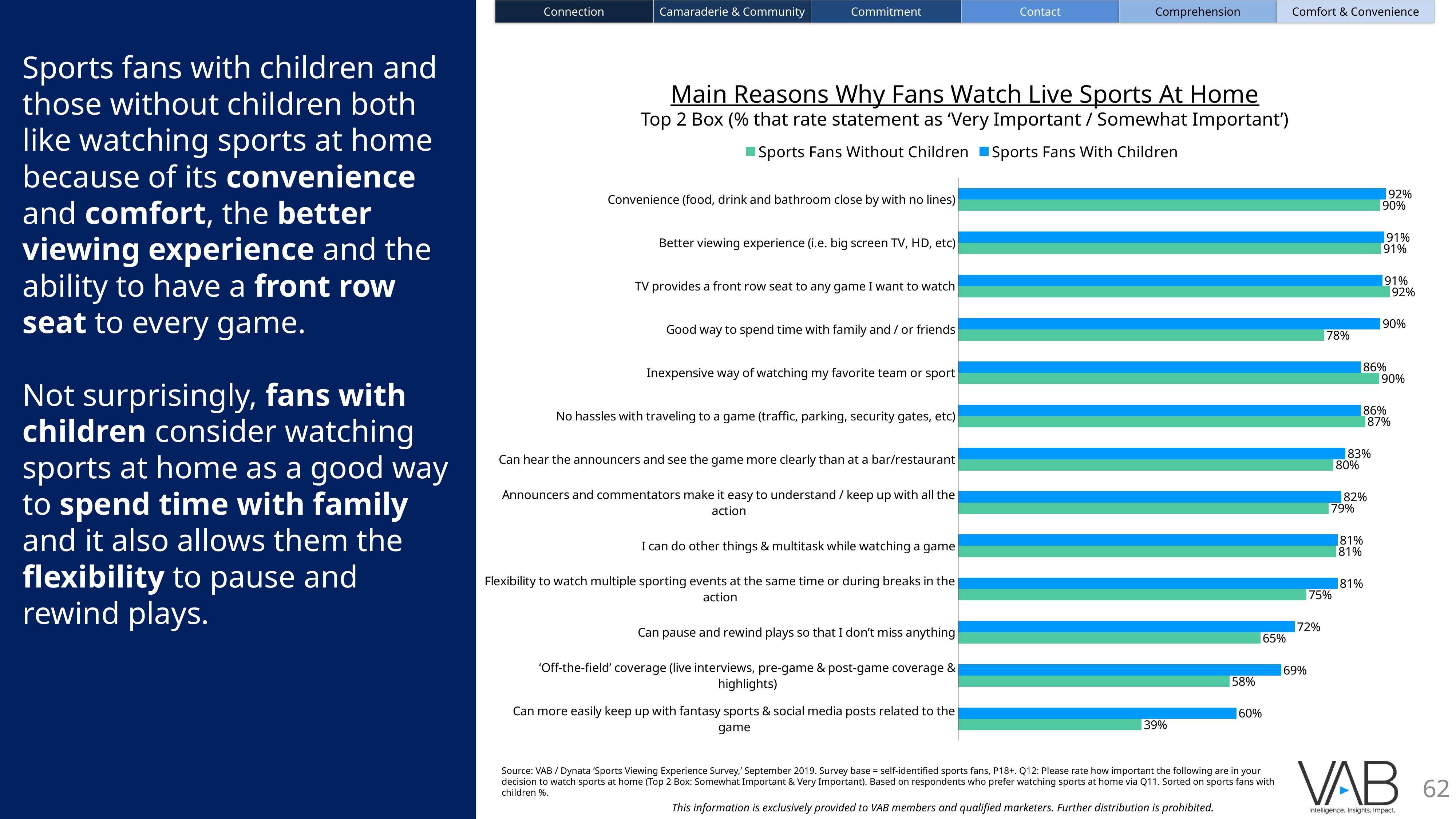
For 'Flexibility to watch multiple sporting events at the same time or during breaks in the action', which group has the higher value? Sports Fans With Children What is the difference between Sports Fans With Children and Sports Fans Without Children for 'Good way to spend time with family and / or friends'? 12 percentage points What type of chart is shown on the slide? Bar chart How many reasons (categories) are shown in the chart? 13 What is the value for Sports Fans Without Children for 'Can pause and rewind plays so that I don't miss anything'? 65% For 'Inexpensive way of watching my favorite team or sport', which group has the higher value? Sports Fans Without Children Which reason has the lowest value for Sports Fans With Children? Can more easily keep up with fantasy sports & social media posts related to the game How many series does the legend list? 2 What percentage of Sports Fans With Children rate 'Good way to spend time with family and / or friends' as important? 90% Which reason has the highest value for Sports Fans Without Children? TV provides a front row seat to any game I want to watch What is the difference between Sports Fans With Children and Sports Fans Without Children for 'Off-the-field coverage (live interviews, pre-game & post-game coverage & highlights)'? 11 percentage points What percentage of Sports Fans Without Children rate 'Can more easily keep up with fantasy sports & social media posts related to the game' as important? 39%